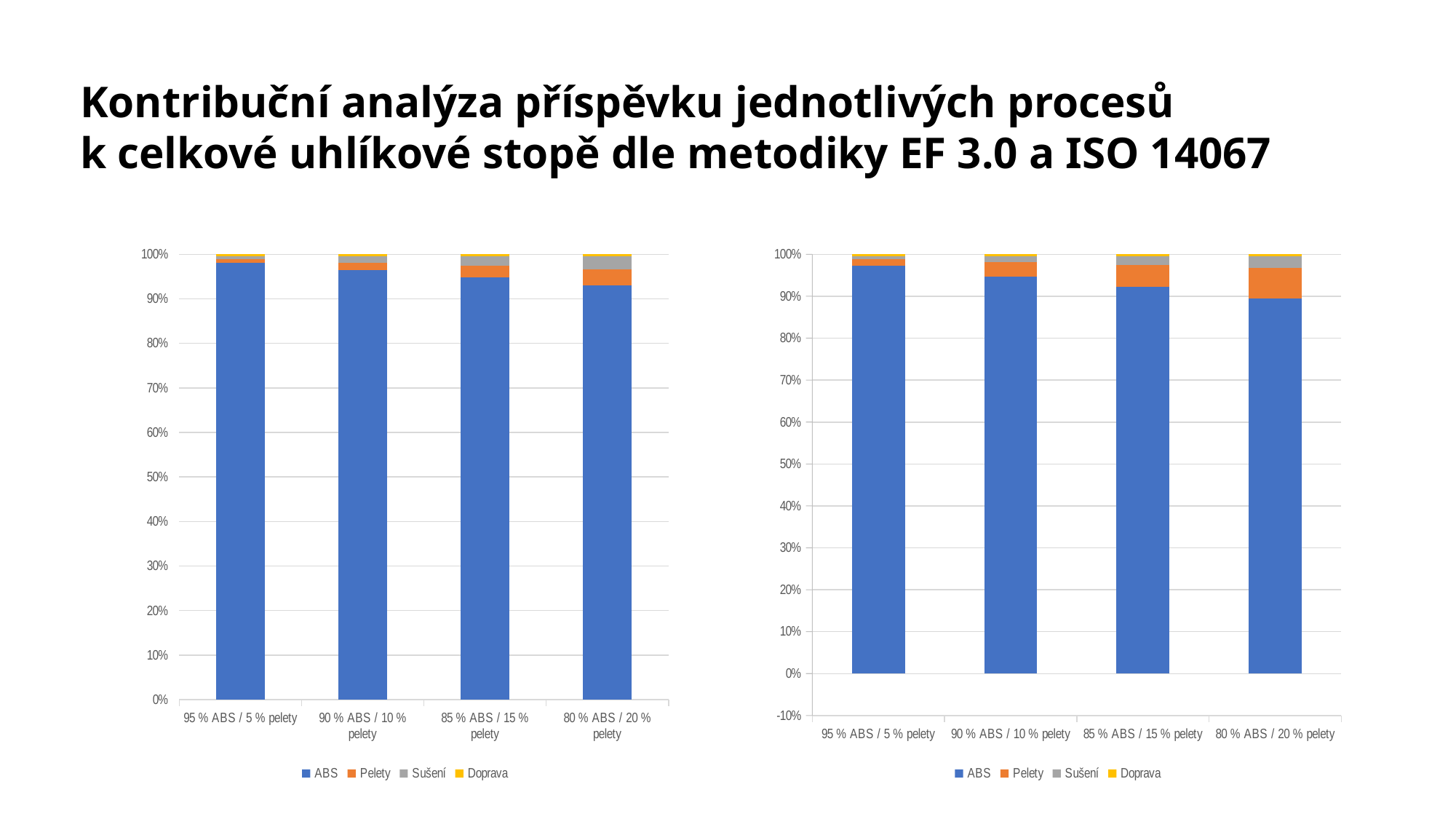
In the left chart, which category has the largest ABS share? 95 % ABS / 5 % pelety In the right chart, which is larger: the Pelety share for 95 % ABS / 5 % pelety or for 80 % ABS / 20 % pelety? 80 % ABS / 20 % pelety Which series is shown in orange in the legend of the left chart? Pelety How many series does the legend of the left chart list? 4 How many categories are shown on the x axis of the right chart? 4 In the left chart, is the ABS share for 80 % ABS / 20 % pelety greater or less than 90%? greater In the left chart, does the ABS share rise or fall moving from left to right along the x axis? fall What kind of chart is the left chart on the slide? stacked bar chart In the right chart, which category has the smallest ABS share? 80 % ABS / 20 % pelety In the right chart, is the ABS share for 95 % ABS / 5 % pelety greater or less than 90%? greater In the right chart, does the Pelety share rise or fall moving from left to right along the x axis? rise What is the lowest tick label on the y axis of the right chart? -10%